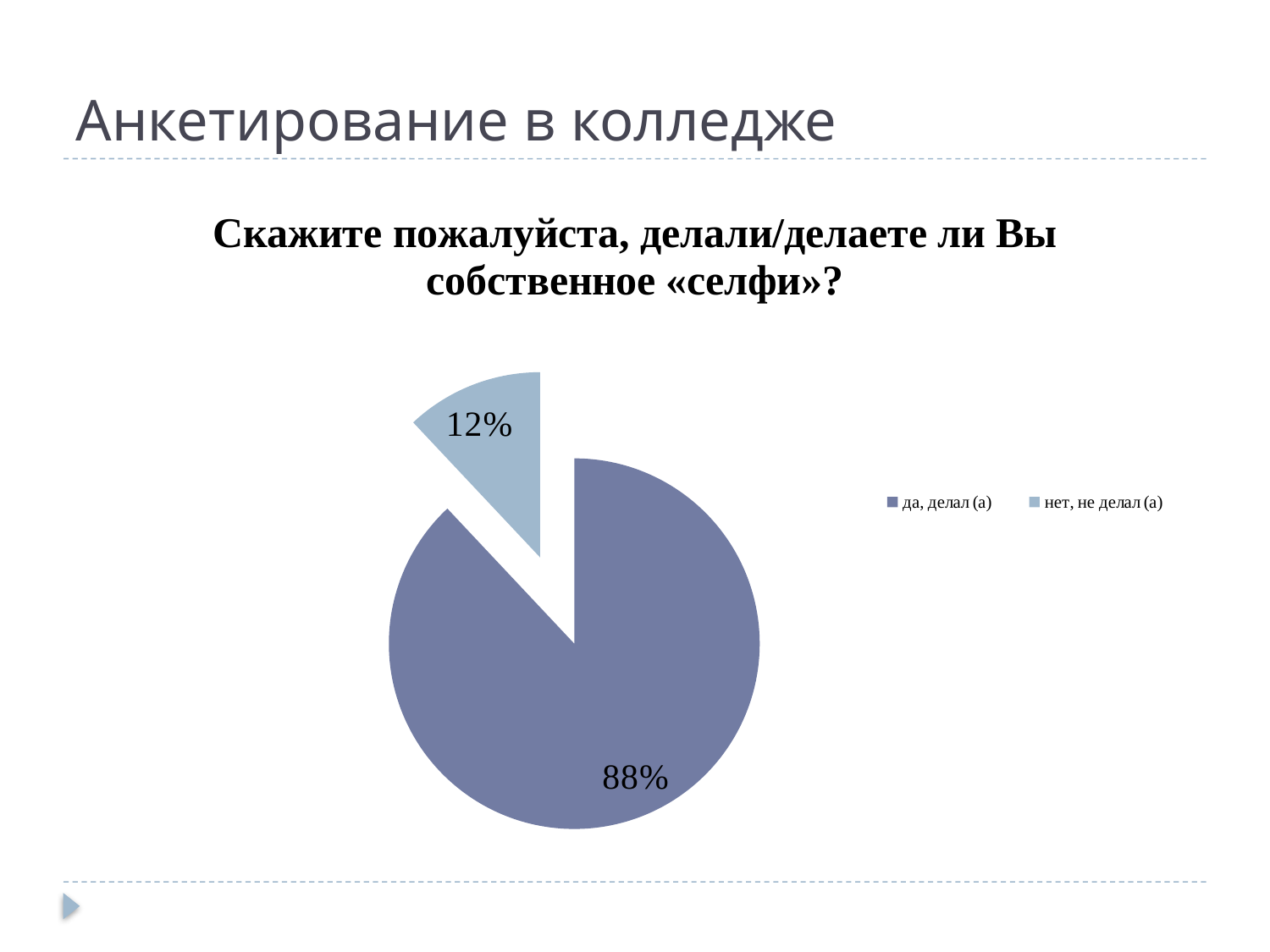
Which category has the smallest slice of the pie? нет, не делал (а) What question is the pie chart answering, according to the heading above it? Скажите пожалуйста, делали/делаете ли Вы собственное «селфи»? Which slice of the pie is pulled out (exploded) from the rest? нет, не делал (а) How many slices does the pie chart have? 2 How many entries does the legend list? 2 What is the difference in percentage points between the "да, делал (а)" slice and the "нет, не делал (а)" slice? 76 Which slice is larger: "да, делал (а)" or "нет, не делал (а)"? да, делал (а) What share of the pie is labelled "да, делал (а)"? 88% What kind of chart is shown on the slide? pie chart Which category has the largest slice of the pie? да, делал (а) What share of the pie is labelled "нет, не делал (а)"? 12%